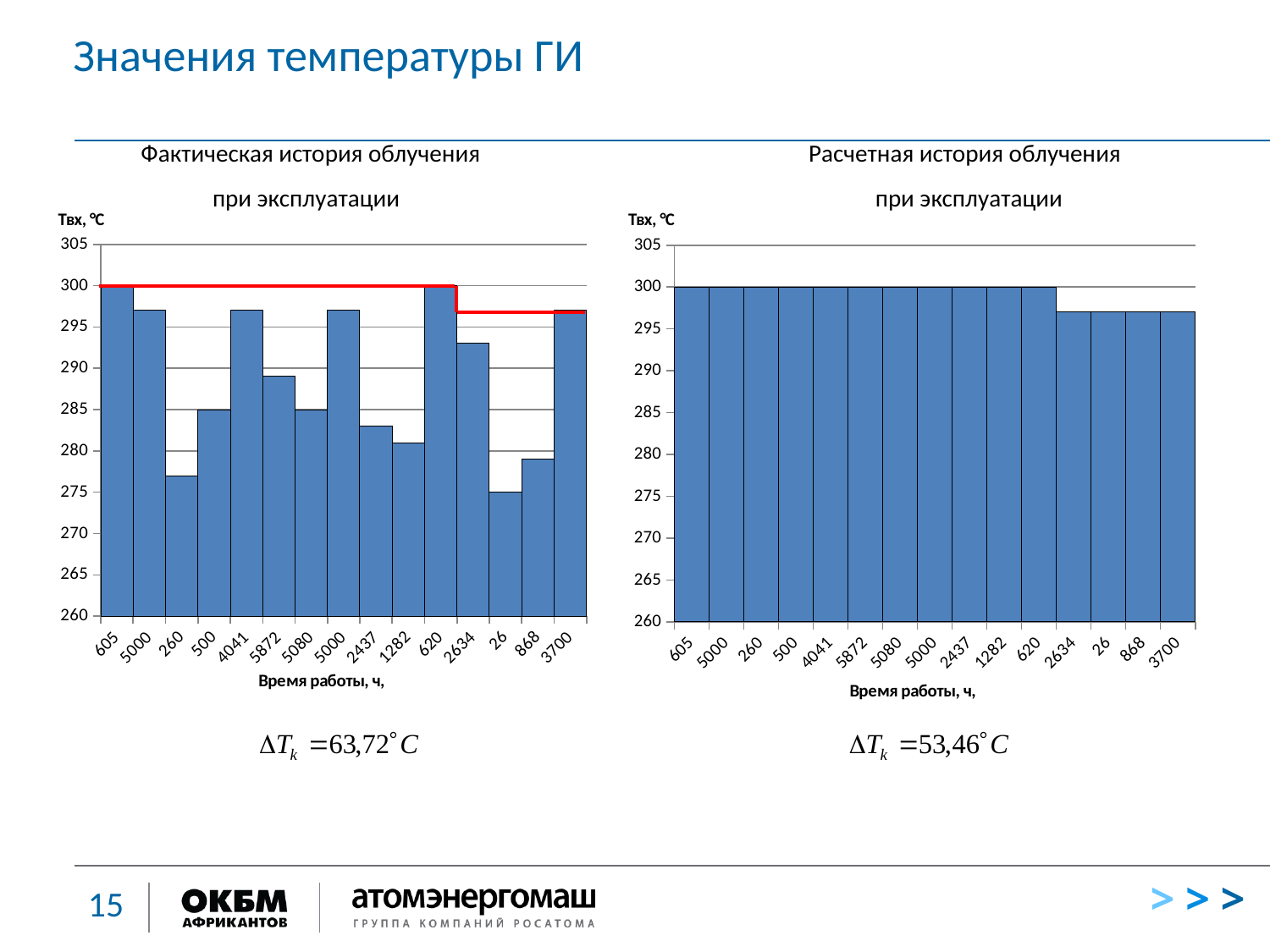
In the left chart, 'Фактическая история облучения при эксплуатации', what is the value for the first category, 605? 300 In the left chart, 'Фактическая история облучения при эксплуатации', which is larger: the value for the second category (5000) or the value for the category 260? 5000 What kind of chart is the left chart, 'Фактическая история облучения при эксплуатации'? bar chart In the left chart, 'Фактическая история облучения при эксплуатации', is the value for the category 5872 greater or less than 285? greater What is the x-axis title of the right chart, 'Расчетная история облучения при эксплуатации'? Время работы, ч, In the right chart, 'Расчетная история облучения при эксплуатации', is the value for the category 2634 greater or less than 300? less In the right chart, 'Расчетная история облучения при эксплуатации', what is the value for the first category, 605? 300 In the left chart, 'Фактическая история облучения при эксплуатации', what is the value for the category 500? 285 In the right chart, 'Расчетная история облучения при эксплуатации', do the values rise or fall from the first category to the last category along the x axis? fall How many bars (categories) are plotted in the left chart, 'Фактическая история облучения при эксплуатации'? 15 In the left chart, 'Фактическая история облучения при эксплуатации', what is the value for the category 26? 275 In the left chart, 'Фактическая история облучения при эксплуатации', is the value for the category 260 greater or less than 280? less